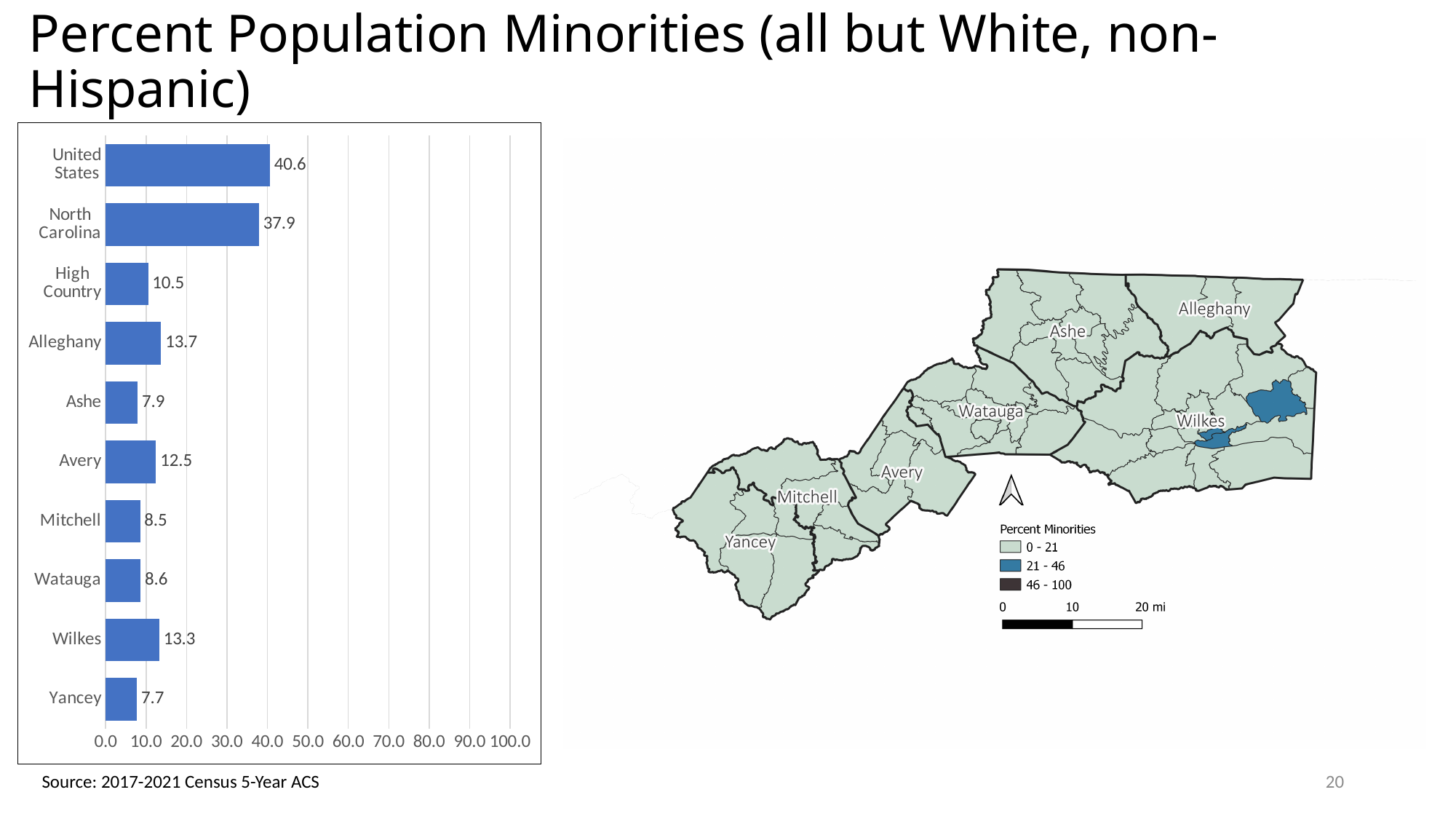
What is the value for Wilkes in the bar chart? 13.3 What kind of chart is shown on the left of the slide? bar chart What is the difference between the United States and North Carolina values in the bar chart? 2.7 Is the value for North Carolina in the bar chart greater or less than 30.0? greater Which category has the lowest value in the bar chart? Yancey What is the value for the United States in the bar chart? 40.6 How many categories are shown in the bar chart? 10 What is the difference between the Wilkes and Ashe values in the bar chart? 5.4 Which category has the highest value in the bar chart? United States Which has a larger value in the bar chart, Alleghany or Avery? Alleghany What is the value for North Carolina in the bar chart? 37.9 What is the value for High Country in the bar chart? 10.5